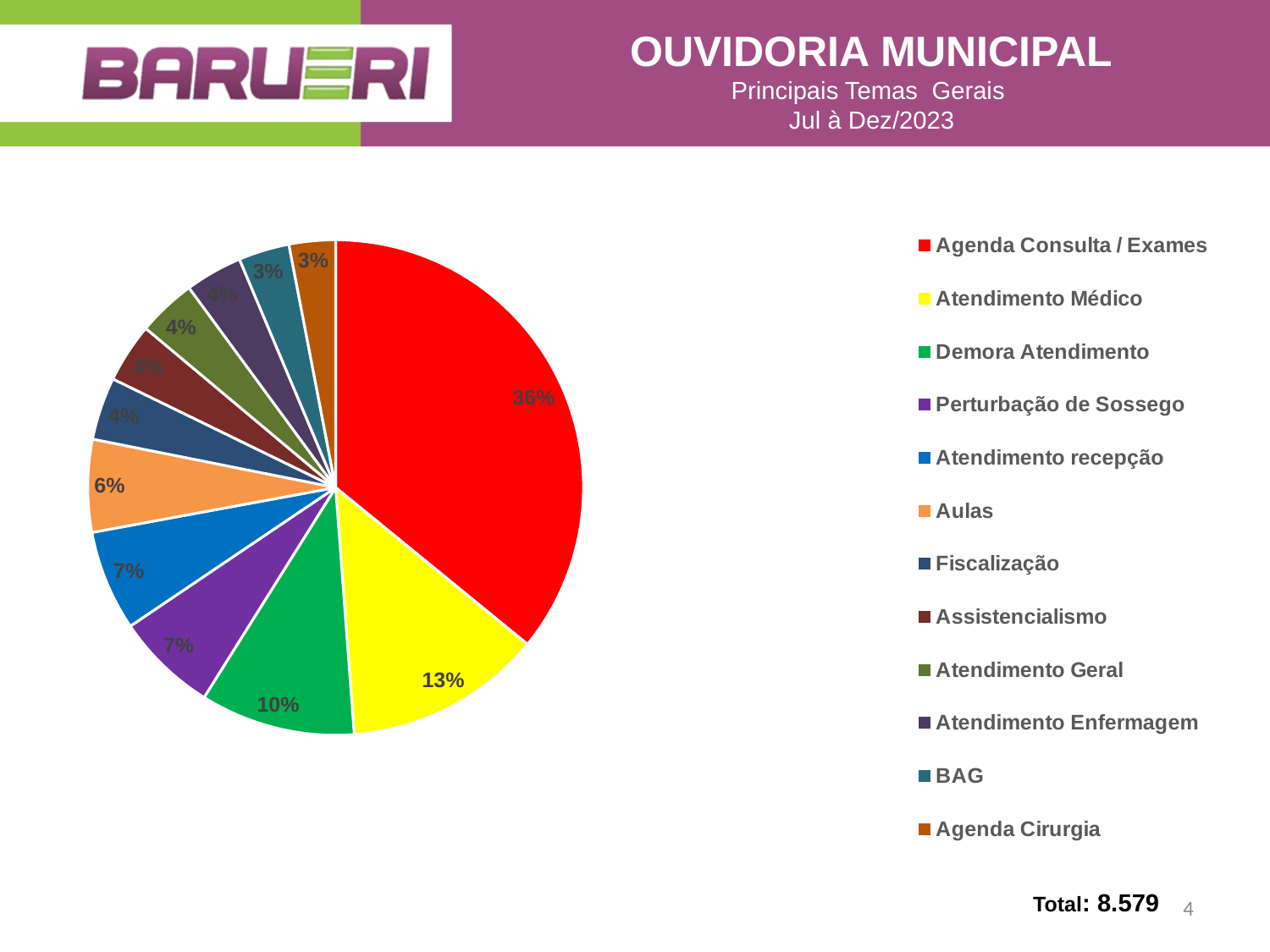
What share of the pie does Atendimento Médico represent? 13% What is the difference in percentage points between Agenda Consulta / Exames and Atendimento Médico? 23 What kind of chart is shown on the slide? pie chart What is the value shown for Aulas? 6% Which is larger, the share for Atendimento Médico or the share for Demora Atendimento? Atendimento Médico What is the value shown for Fiscalização? 4% How many categories does the pie chart have? 12 What total is printed at the bottom right of the slide? 8.579 What period does the slide subtitle say the data covers? Jul à Dez/2023 Which category has the largest share of the pie? Agenda Consulta / Exames What is the value shown for Demora Atendimento? 10% What share of the pie does Agenda Consulta / Exames represent? 36%